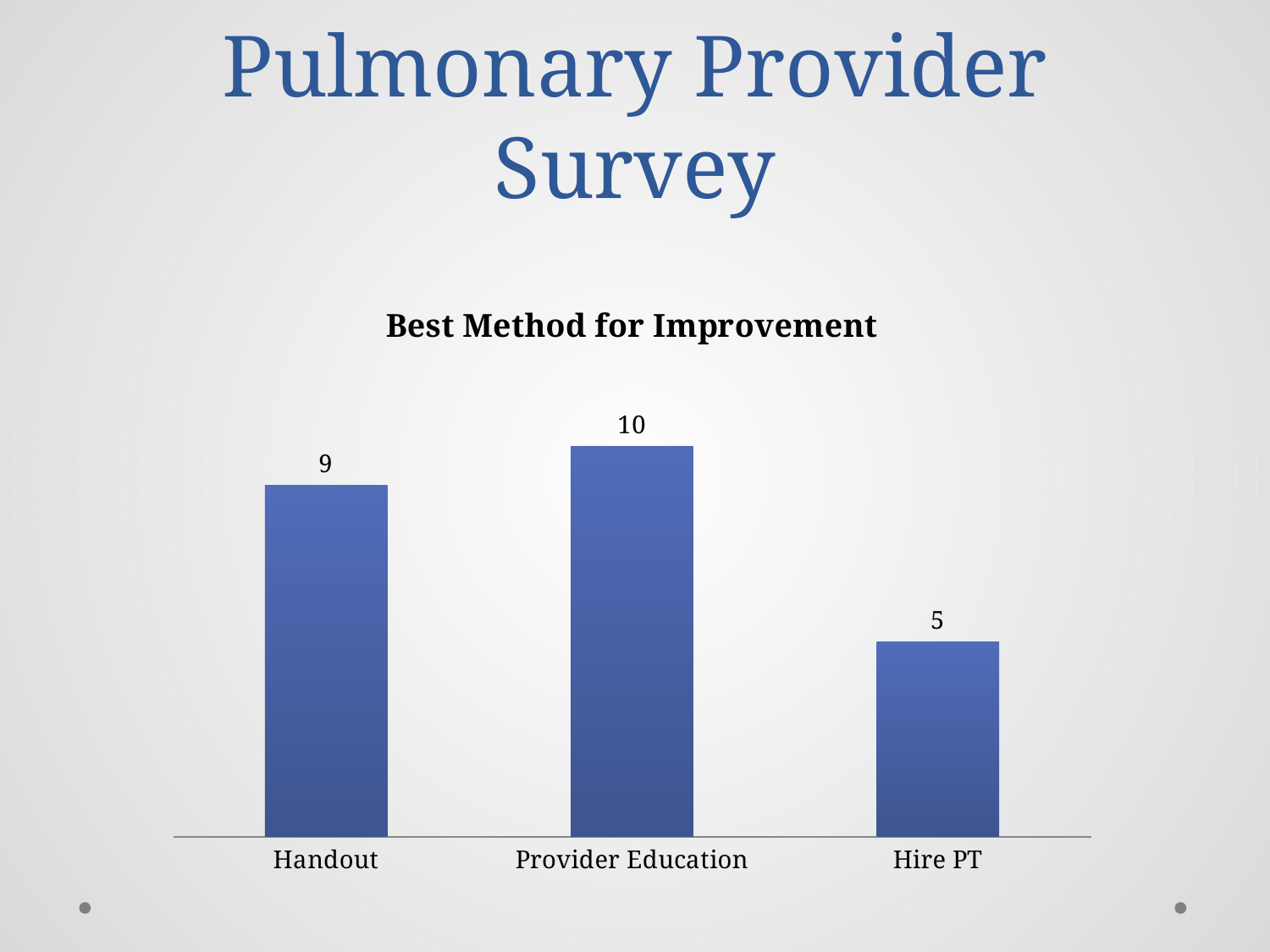
Which category has the highest value? Provider Education What is the value for Handout? 9 What is the value for Hire PT? 5 Which is larger, the value for Handout or the value for Hire PT? Handout What is the total of the values for all three categories? 24 What kind of chart is shown on the slide? Bar chart How many categories are shown in the chart? 3 Which category has the lowest value? Hire PT What is the title of the chart? Best Method for Improvement What is the difference between the values for Handout and Hire PT? 4 What is the difference between the values for Provider Education and Hire PT? 5 What is the value for Provider Education? 10